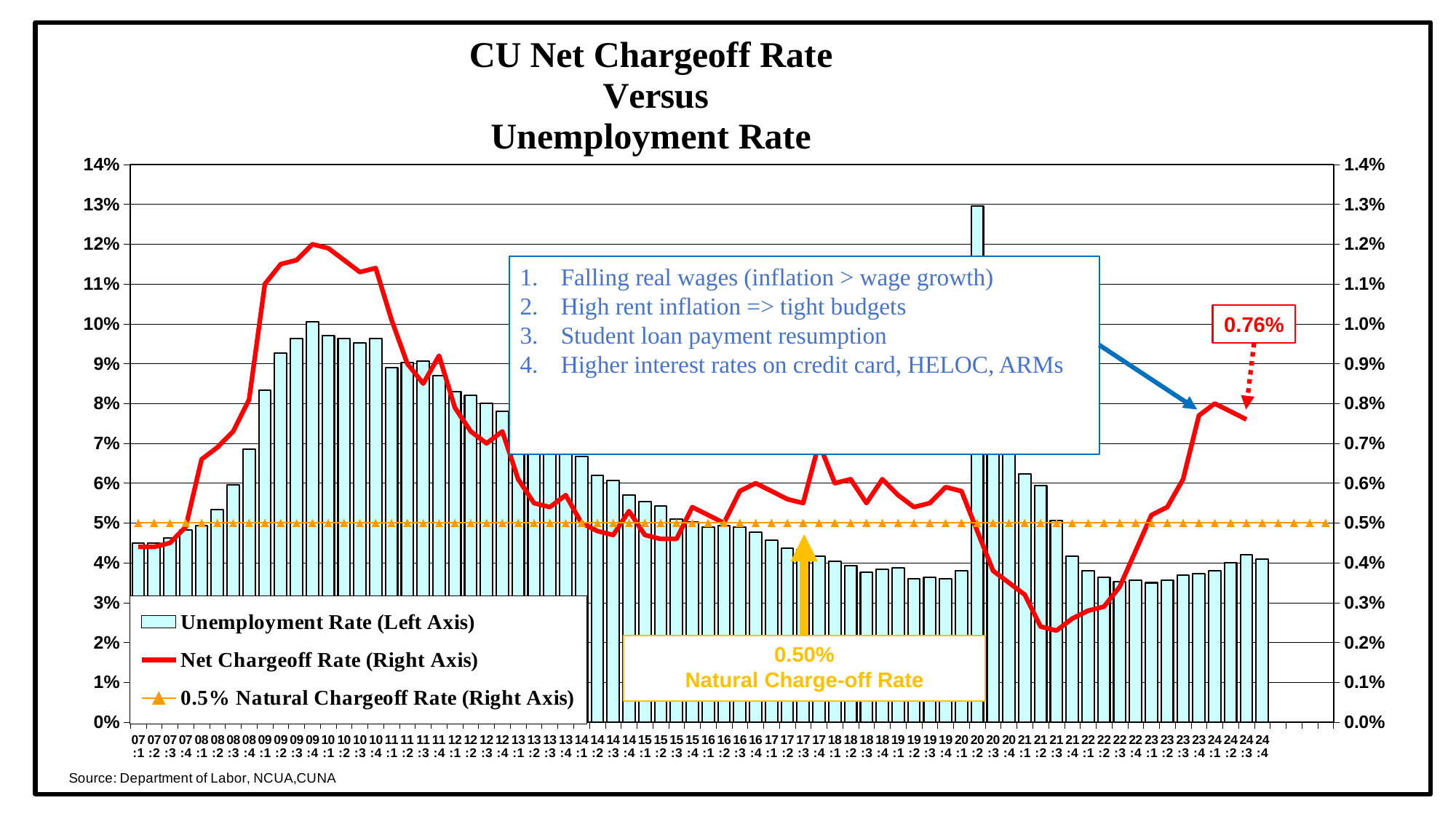
Is the Net Chargeoff Rate for 09:4 greater or less than 1.1%? greater What is the title of the chart? CU Net Chargeoff Rate Versus Unemployment Rate In which quarter does the Net Chargeoff Rate line reach its peak? 09:4 Which series is plotted as bars? Unemployment Rate (Left Axis) In which quarter is the Unemployment Rate bar highest? 20:2 What value is given for the Natural Charge-off Rate? 0.50% Is the Net Chargeoff Rate for 21:2 greater or less than 0.3%? less What is the Net Chargeoff Rate labelled at the end of the series (24:4)? 0.76% How many series does the legend list? 3 Is the Unemployment Rate for 20:2 greater or less than 12%? greater Which is larger, the Unemployment Rate for 20:2 or for 24:4? 20:2 Does the Net Chargeoff Rate rise or fall from 21:3 to 24:1? rise